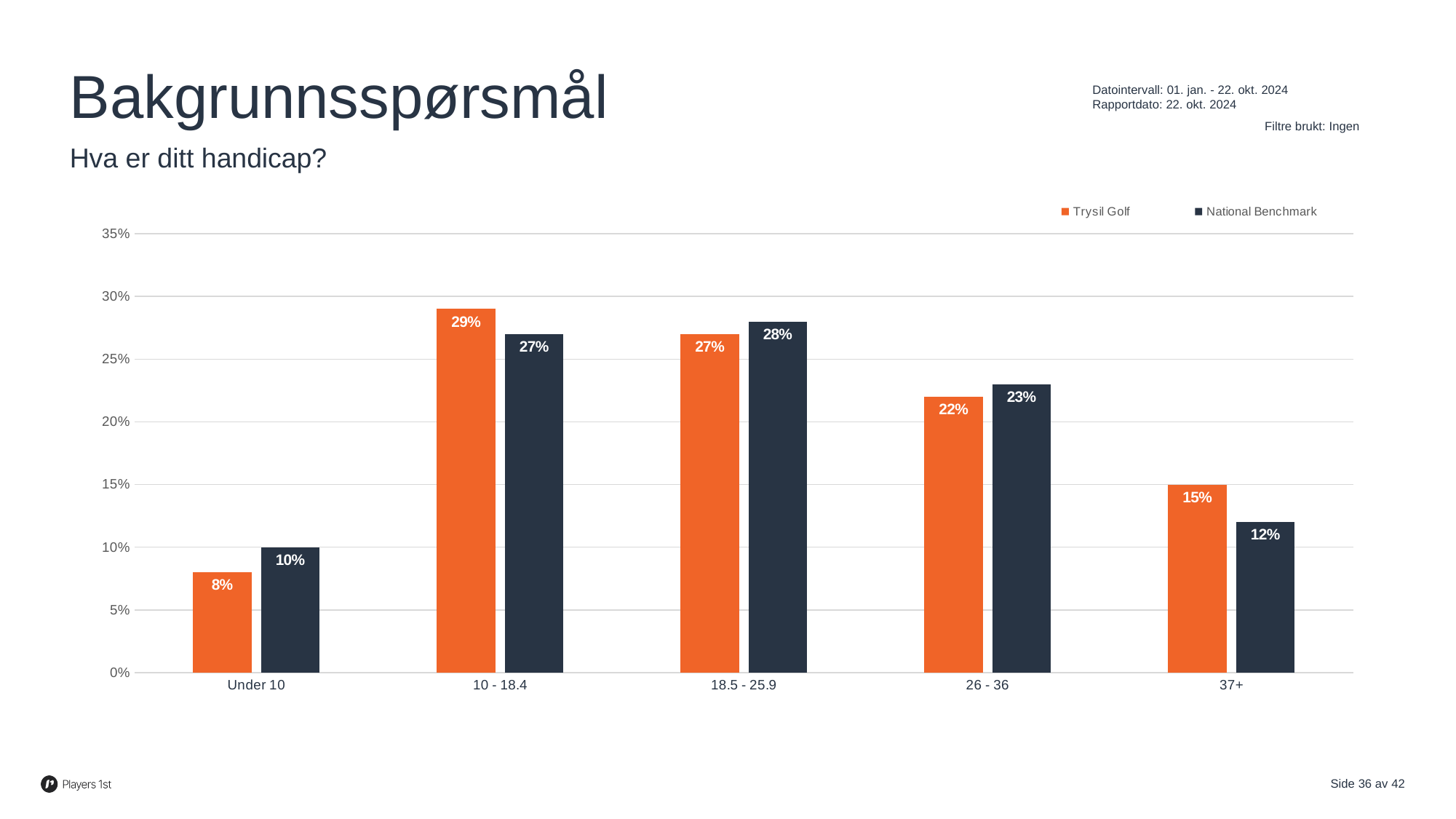
Is the National Benchmark value for 26 - 36 greater or less than 20%? greater Which series is shown in orange in the legend? Trysil Golf What is the difference between the Trysil Golf and National Benchmark values for the 37+ category? 3% What is the National Benchmark value for the 37+ handicap category? 12% What kind of chart is shown on the slide? Bar chart How many series does the legend list? 2 How many handicap categories are shown on the x axis? 5 For the 18.5 - 25.9 category, which is larger: Trysil Golf or National Benchmark? National Benchmark Which handicap category has the highest Trysil Golf value? 10 - 18.4 Which handicap category has the lowest National Benchmark value? Under 10 What is the Trysil Golf value for the 10 - 18.4 handicap category? 29% What is the Trysil Golf value for the Under 10 category? 8%